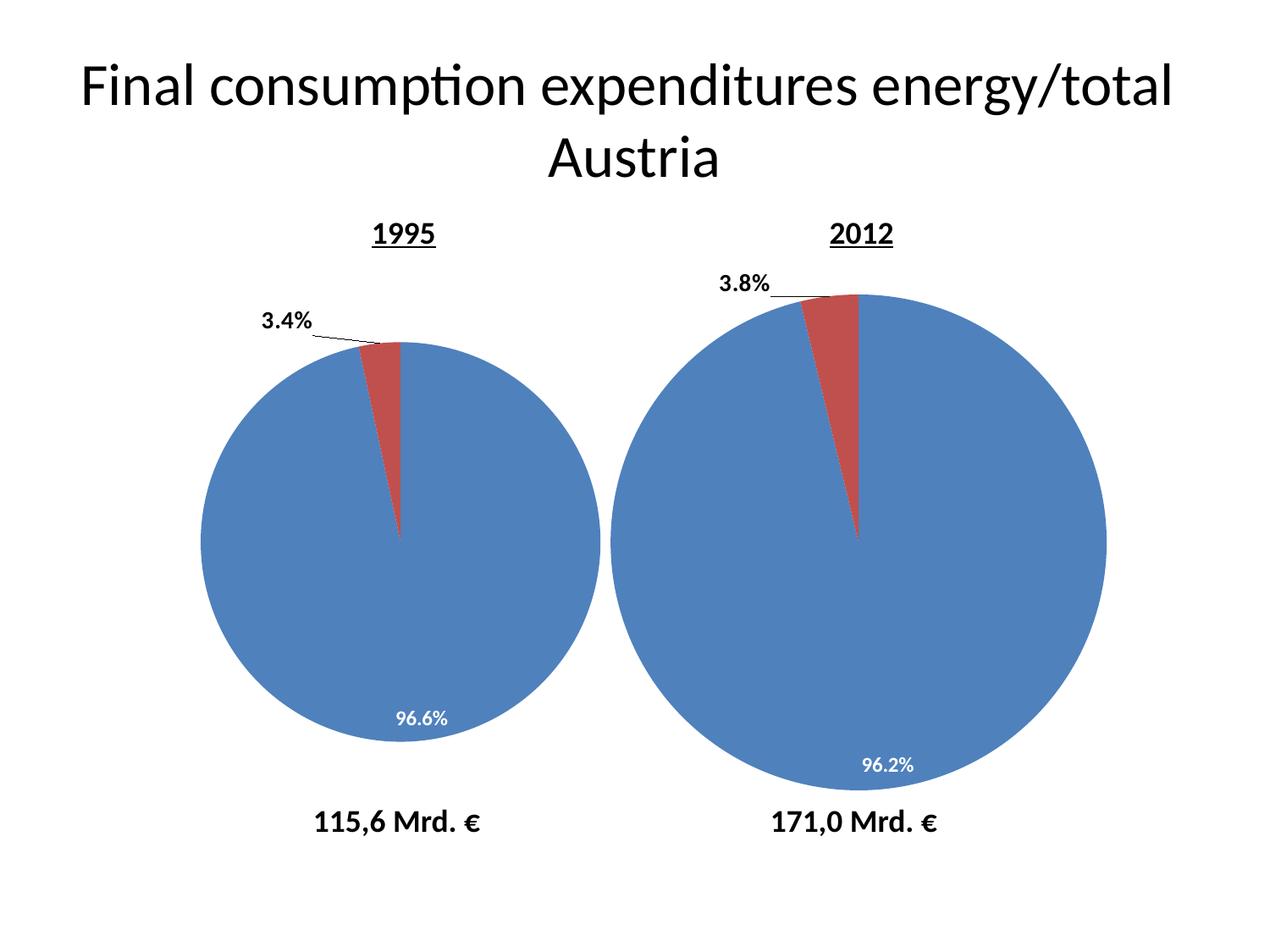
In the 1995 pie chart, what share does the red slice represent? 3.4% Which pie chart has the larger red slice, 1995 or 2012? 2012 In the 1995 pie chart, what share does the blue slice represent? 96.6% In the 2012 pie chart, what share does the red slice represent? 3.8% In the 1995 pie chart, which slice is larger, the blue one or the red one? The blue one What is the title of the slide containing the two pie charts? Final consumption expenditures energy/total Austria How many slices does the 1995 pie chart have? 2 What kind of charts are shown on the slide? Pie charts What total amount is printed below the 2012 pie chart? 171,0 Mrd. € What total amount is printed below the 1995 pie chart? 115,6 Mrd. € By how many percentage points is the red slice in the 2012 pie chart larger than the red slice in the 1995 pie chart? 0.4 percentage points